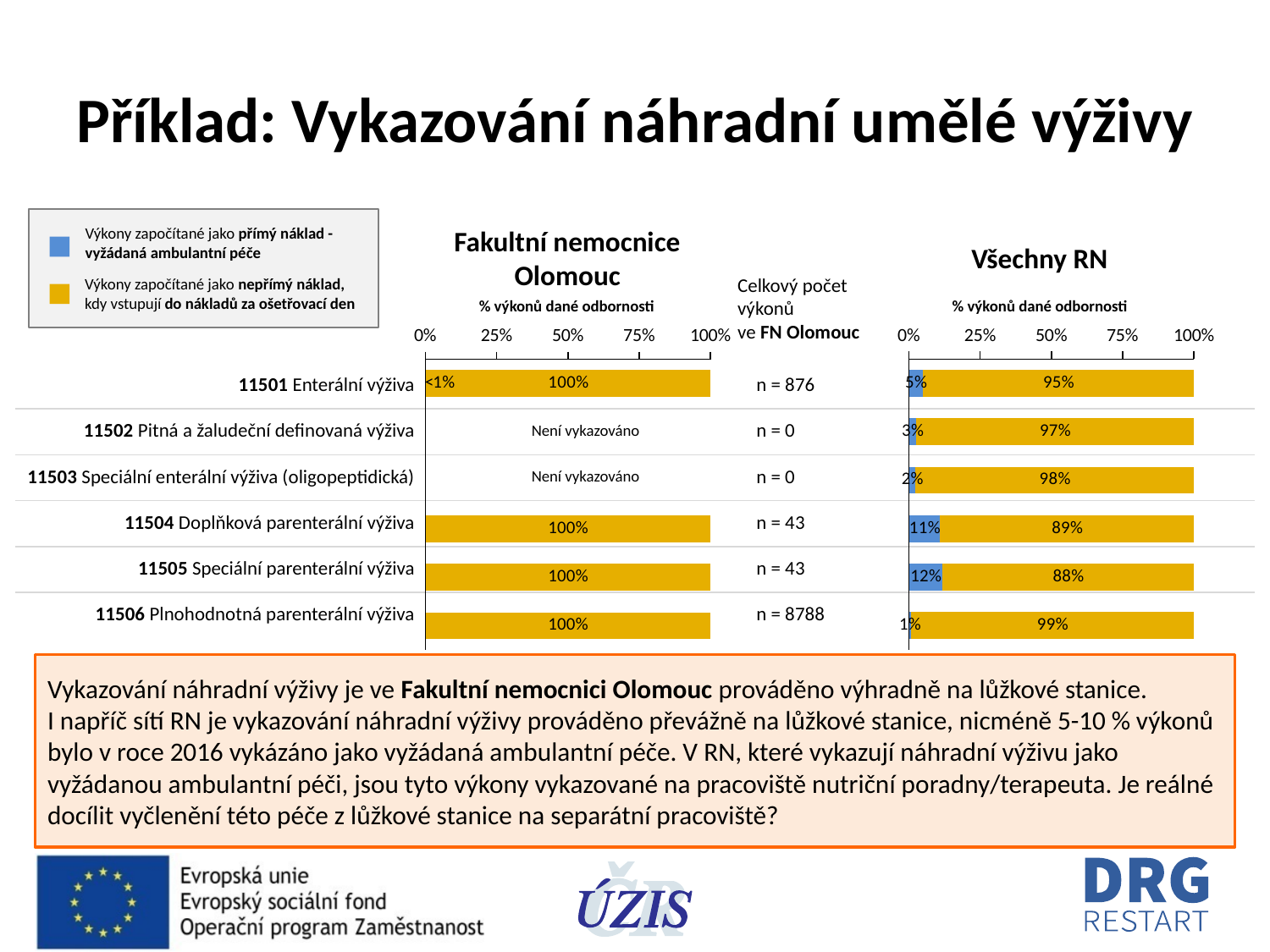
In the 'Všechny RN' chart, which category has the lowest blue (přímý náklad) share? 11506 Plnohodnotná parenterální výživa What is the total number of výkony (n) for 11506 in FN Olomouc? n = 8788 How many series does the legend list? 2 In the 'Všechny RN' chart, what is the difference between the yellow values for 11503 and 11504? 9% In the 'Všechny RN' chart, which category has the highest blue (přímý náklad) share? 11505 Speciální parenterální výživa What type of chart is the 'Všechny RN' chart? Stacked bar chart In the 'Všechny RN' chart, what is the yellow (nepřímý náklad) value for 11501 Enterální výživa? 95% In the 'Fakultní nemocnice Olomouc' chart, what is the yellow value for 11506 Plnohodnotná parenterální výživa? 100% In the 'Všechny RN' chart, what is the blue (přímý náklad) value for 11505 Speciální parenterální výživa? 12% In the 'Všechny RN' chart, which is larger: the blue share for 11504 or for 11502? 11504 How many categories are listed in the 'Všechny RN' chart? 6 In the 'Fakultní nemocnice Olomouc' chart, what is shown for 11502 Pitná a žaludeční definovaná výživa? Není vykazováno